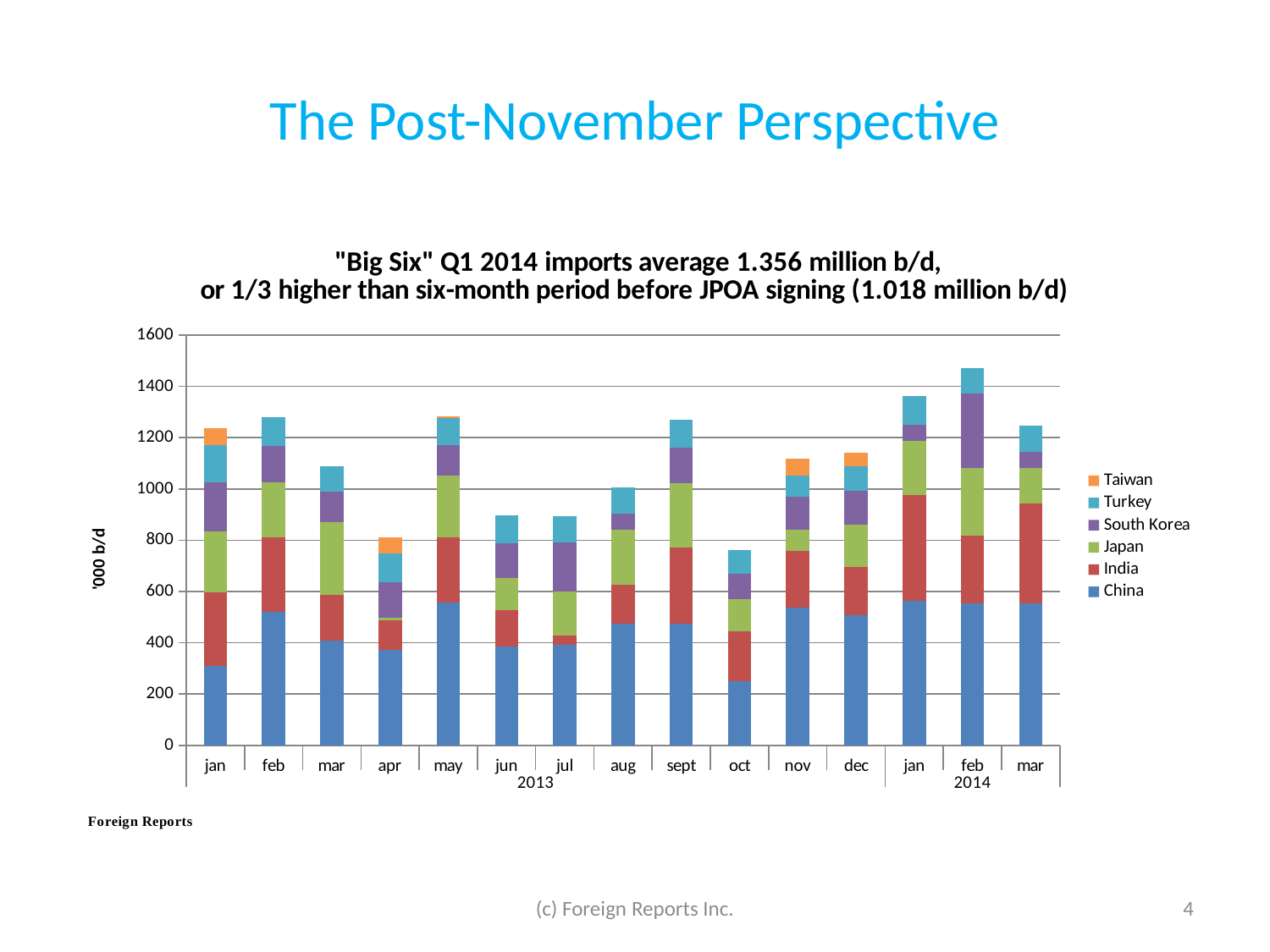
Do the stacked totals rise or fall from oct 2013 to feb 2014? rise Which month has the shortest stacked bar? oct 2013 What kind of chart is shown on the slide? stacked bar chart Which bar is taller, feb 2014 or oct 2013? feb 2014 Is the total for feb 2014 greater or less than 1400? greater Which month has the tallest stacked bar? feb 2014 Is the total for jan 2014 greater or less than 1200? greater Is the total for jun 2013 greater or less than 1000? less How many monthly bars are plotted in the chart? 15 Which country is listed at the top of the legend? Taiwan How many series does the legend list? 6